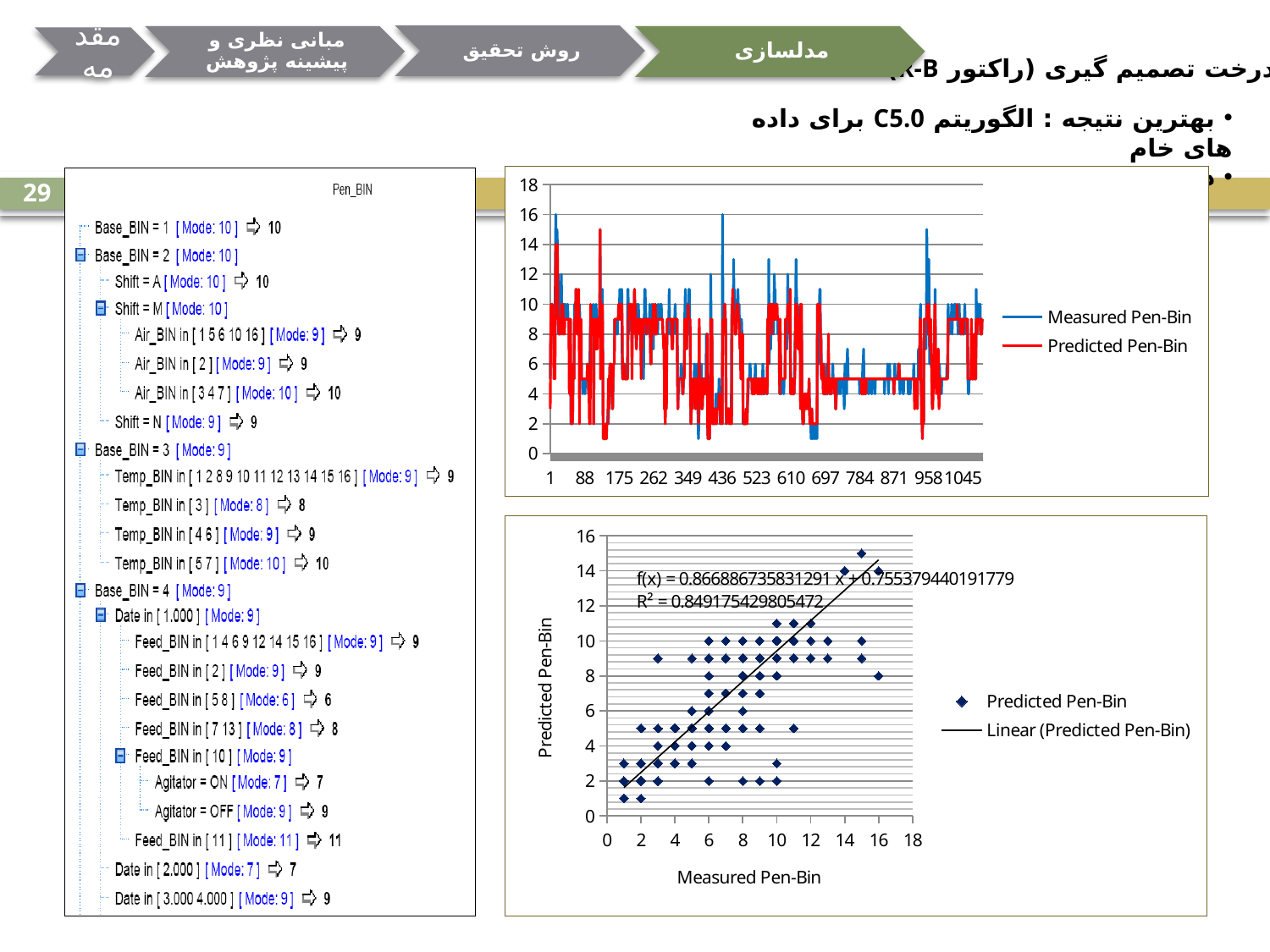
What kind of chart is the bottom-right chart plotting Predicted Pen-Bin against Measured Pen-Bin? scatter chart What is the R² value printed on the bottom-right scatter chart? 0.849175429805472 What is the slope of the linear fit shown on the bottom-right scatter chart? 0.866886735831291 How many series does the legend of the top-right line chart list? 2 What is the x-axis title of the bottom-right scatter chart? Measured Pen-Bin What are the two legend entries of the top-right line chart? Measured Pen-Bin, Predicted Pen-Bin What kind of chart is the top-right chart showing Measured Pen-Bin and Predicted Pen-Bin? line chart How many entries does the legend of the bottom-right scatter chart list? 2 What is the intercept of the linear fit shown on the bottom-right scatter chart? 0.755379440191779 What is the fitted equation printed on the bottom-right scatter chart? f(x) = 0.866886735831291 x + 0.755379440191779 In the bottom-right scatter chart, does the linear trendline rise or fall as Measured Pen-Bin increases? rise